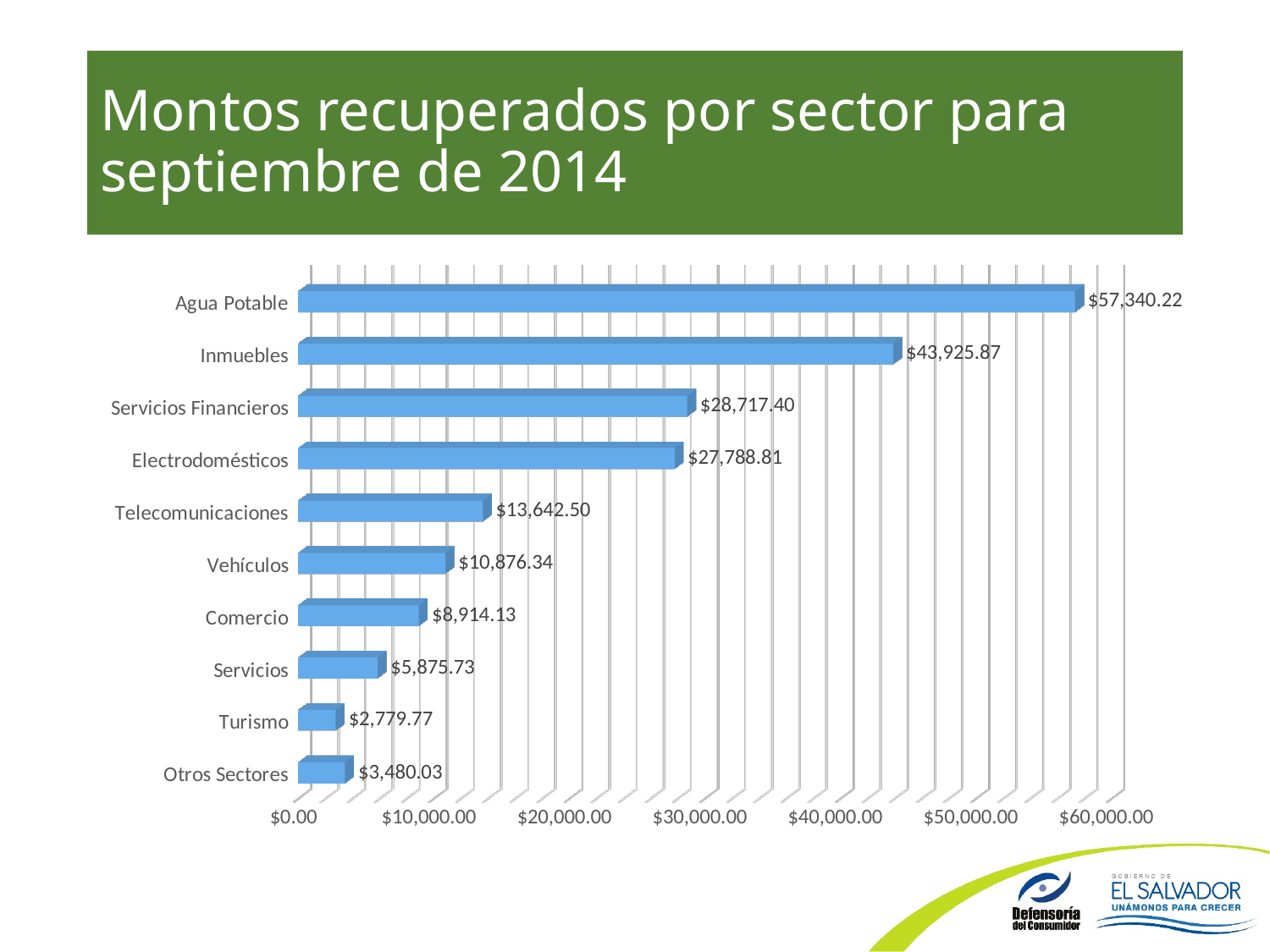
What is the difference between the values for Agua Potable and Inmuebles? $13,414.35 Is the value for Inmuebles greater or less than $40,000.00? greater Which is larger, the value for Vehículos or the value for Comercio? Vehículos What kind of chart is shown on the slide? Bar chart Which sector has the lowest recovered amount? Turismo What is the value for Comercio? $8,914.13 What is the value for Otros Sectores? $3,480.03 What is the difference between the values for Servicios Financieros and Electrodomésticos? $928.59 How many sectors are shown in the chart? 10 Which sector has the highest recovered amount? Agua Potable What is the value for Telecomunicaciones? $13,642.50 What is the value for Agua Potable? $57,340.22